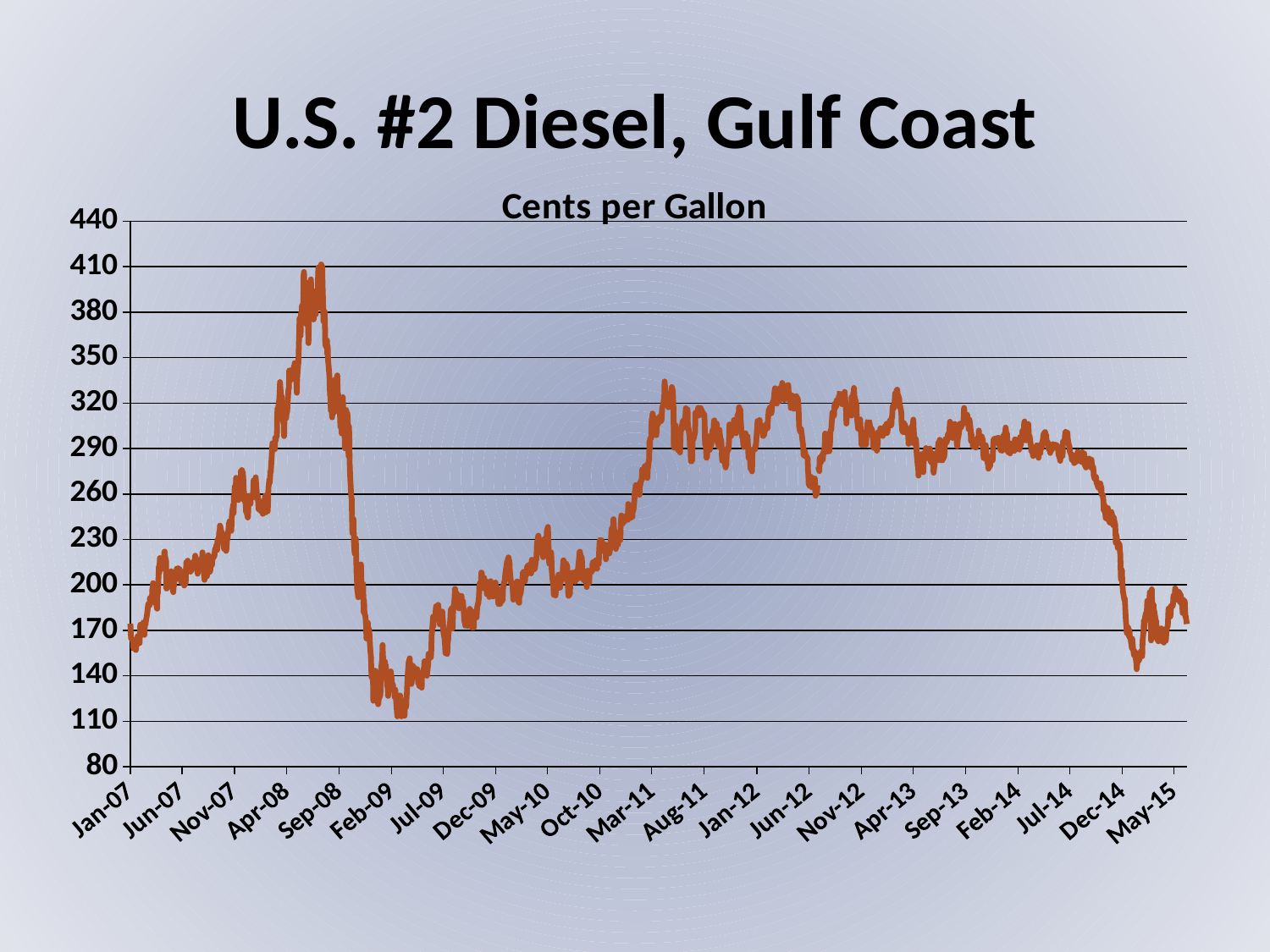
What kind of chart is shown on the slide? line chart What unit is the vertical axis measured in, according to the chart subtitle? Cents per Gallon Is the value at May-15 greater or less than 200? less Around which x-axis label does the diesel price reach its highest point? Sep-08 Around which x-axis label does the diesel price reach its lowest point? Feb-09 Is the peak value near Sep-08 greater or less than 380? greater Which is larger, the value near Sep-08 or the value near Feb-09? Sep-08 Does the diesel price rise or fall between Jul-14 and Dec-14? fall Is the value at Jul-14 greater or less than 260? greater What is the title of the chart? U.S. #2 Diesel, Gulf Coast Does the diesel price rise or fall between Jan-07 and Sep-08? rise